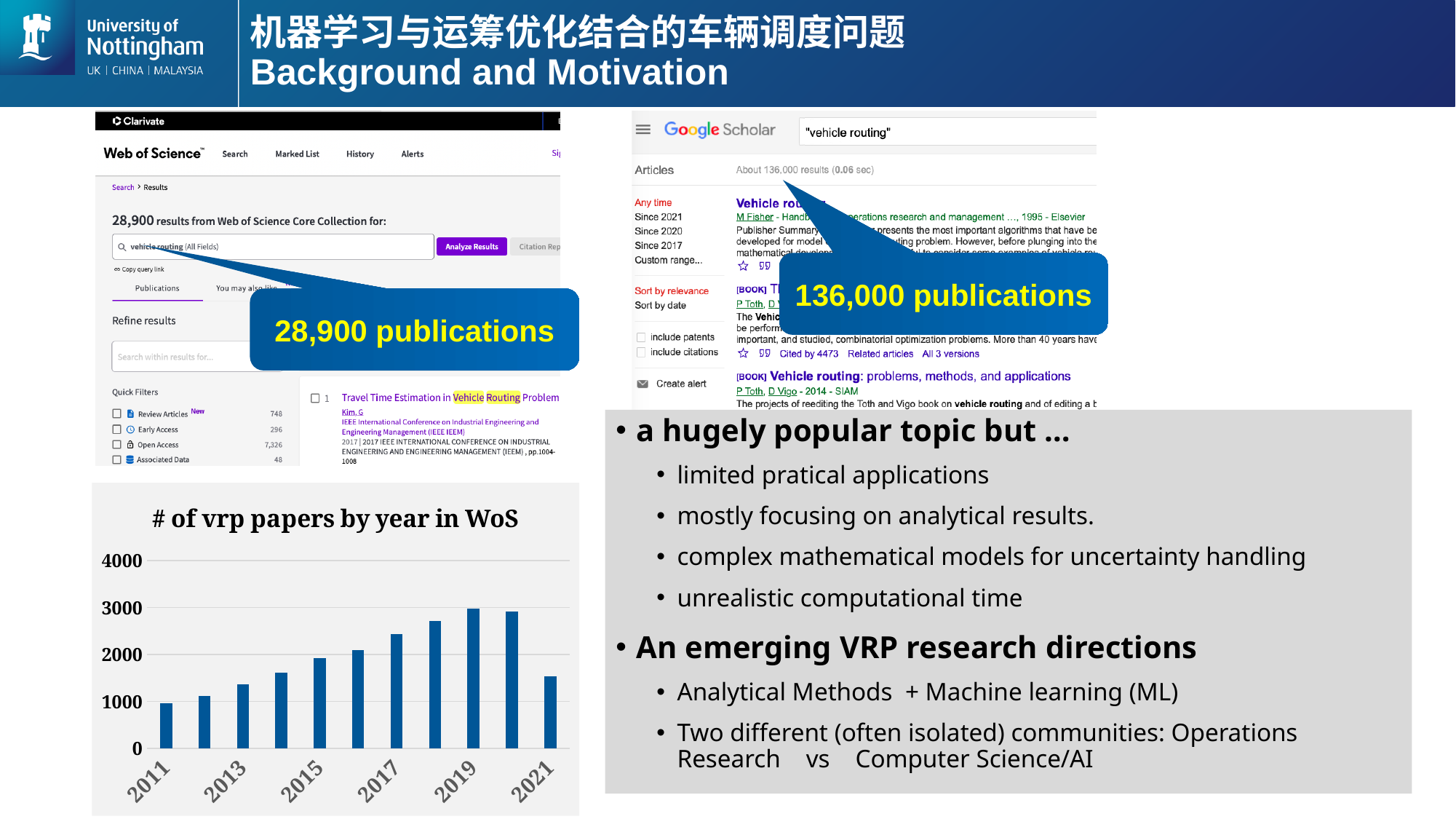
Which year has more VRP papers, 2011 or 2021? 2021 Which year has more VRP papers, 2017 or 2021? 2017 How does the number of VRP papers change from 2011 to 2019? It rises every year What is the title of the chart on the slide? # of vrp papers by year in WoS Is the value for 2021 greater or less than 2000? less Which year has the lowest number of VRP papers in the chart? 2011 Is the value for 2019 greater or less than 2000? greater What kind of chart is shown at the bottom left of the slide? bar chart Is the value for 2017 greater or less than 3000? less How many years (bars) are plotted in the chart? 11